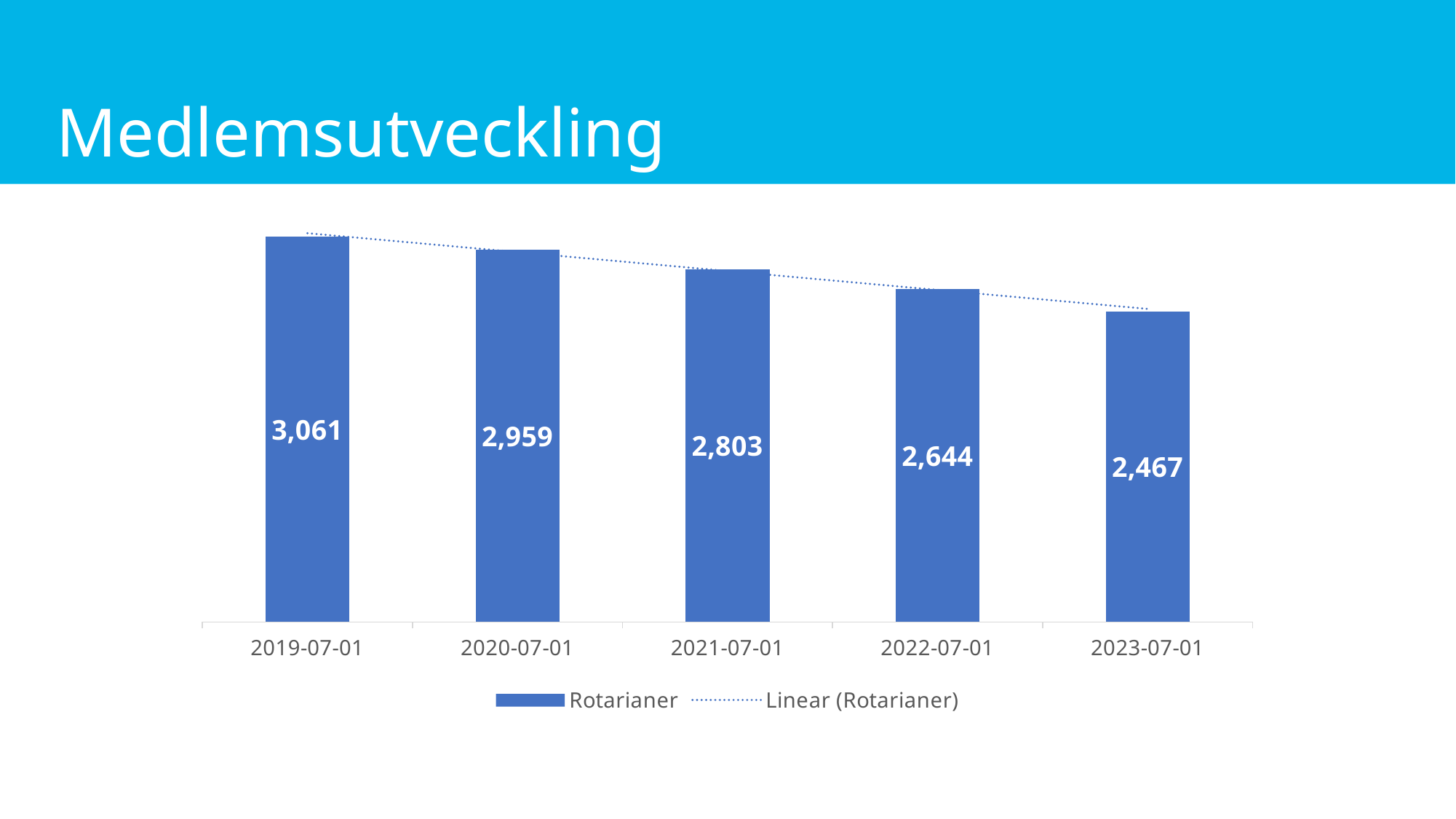
What is the value for Rotarianer on 2019-07-01? 3,061 Which date has the lowest number of Rotarianer? 2023-07-01 What is the value for Rotarianer on 2023-07-01? 2,467 Which is larger, the value for 2020-07-01 or the value for 2022-07-01? 2020-07-01 What kind of chart is shown on the slide? Bar chart What is the value for Rotarianer on 2021-07-01? 2,803 What is the difference between the values for 2019-07-01 and 2023-07-01? 594 Which date has the highest number of Rotarianer? 2019-07-01 How many entries does the legend list? 2 Do the values rise or fall from 2019-07-01 to 2023-07-01? Fall What is the difference between the values for 2020-07-01 and 2021-07-01? 156 How many dates are shown on the x axis? 5